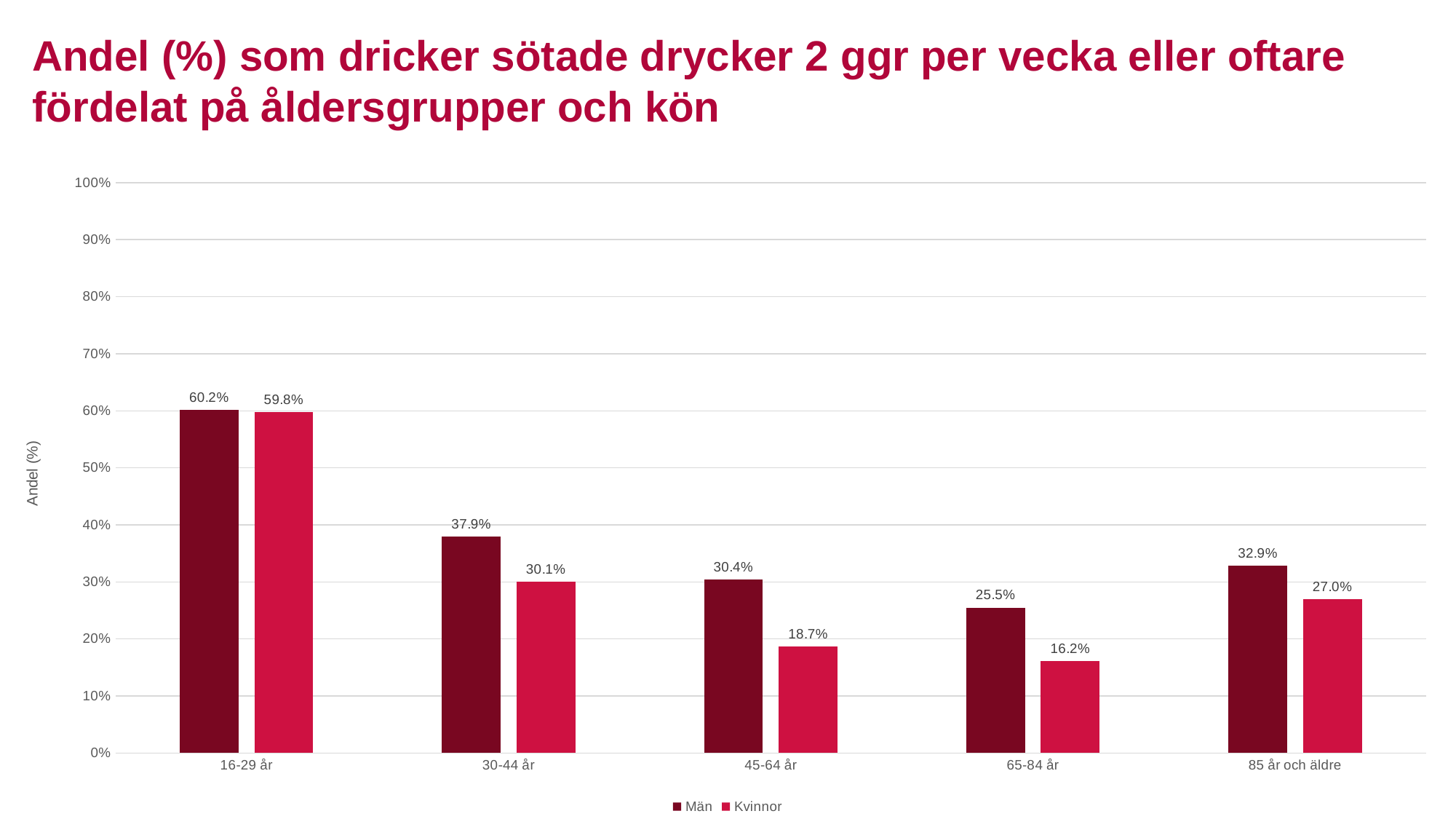
Which age group has the lowest value for Män? 65-84 år What is the value for Män in the 16-29 år age group? 60.2% Do the values for Kvinnor rise or fall from 16-29 år to 65-84 år? Fall What is the label of the y axis? Andel (%) How many age groups are shown on the x axis? 5 How many series does the legend list? 2 What is the difference between Män and Kvinnor in the 30-44 år age group? 7.8% What kind of chart is shown on the slide? Bar chart Which is larger in the 65-84 år age group, Män or Kvinnor? Män Which age group has the highest value for Kvinnor? 16-29 år What is the value for Kvinnor in the 85 år och äldre age group? 27.0% What is the value for Kvinnor in the 45-64 år age group? 18.7%